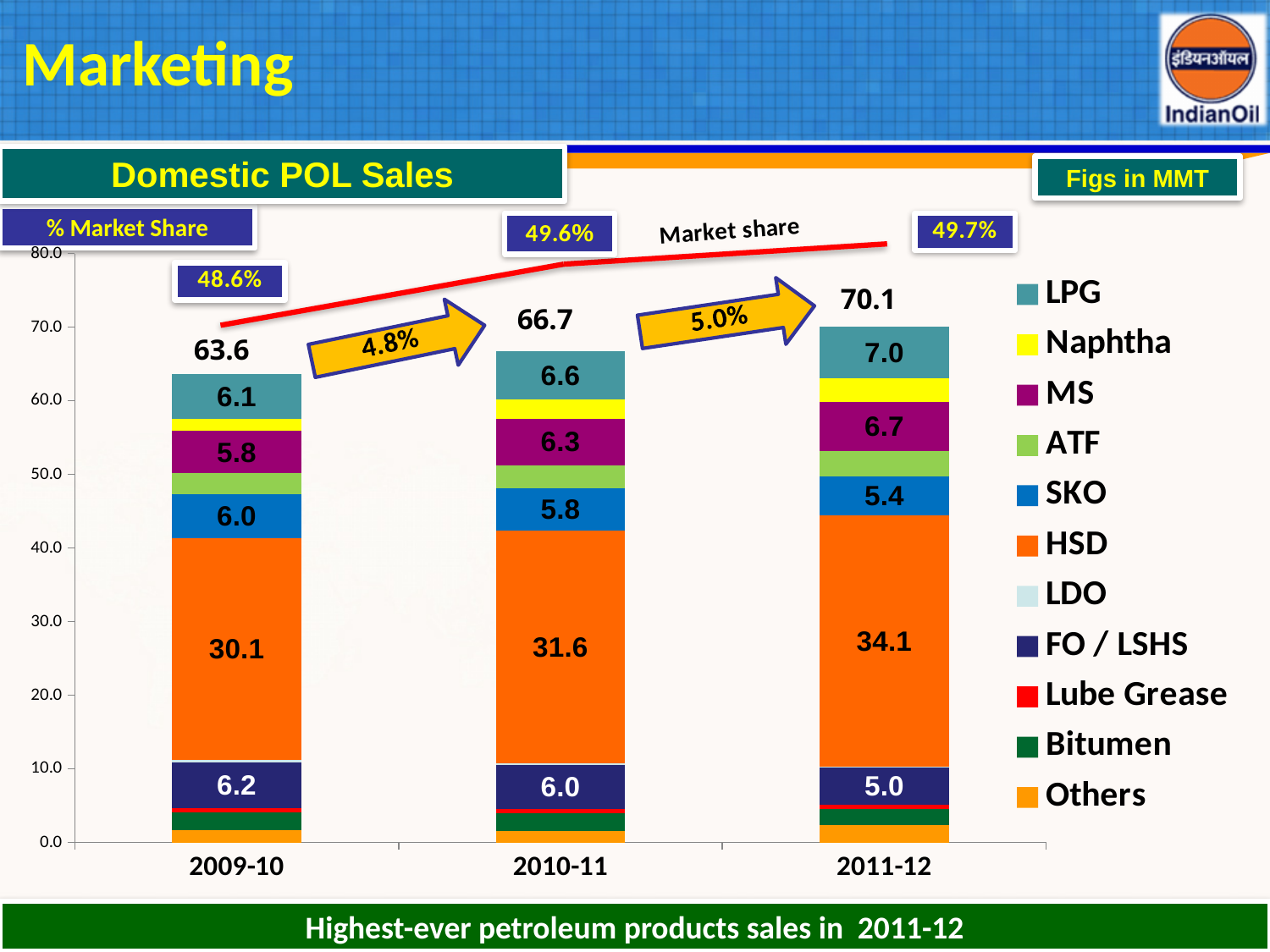
What kind of chart is used to show Domestic POL Sales? Stacked bar chart How many series does the legend list? 11 What is the LPG value for 2009-10? 6.1 What is the total Domestic POL Sales for 2011-12? 70.1 What is the difference in HSD sales between 2011-12 and 2009-10? 4.0 Which year has the highest total Domestic POL Sales? 2011-12 What is the % Market Share shown for 2010-11? 49.6% What is the FO / LSHS value for 2009-10? 6.2 What is the HSD value for 2010-11? 31.6 What is the SKO value for 2011-12? 5.4 Is the MS value for 2011-12 larger or smaller than the MS value for 2009-10? larger How many years are shown on the x axis of the chart? 3